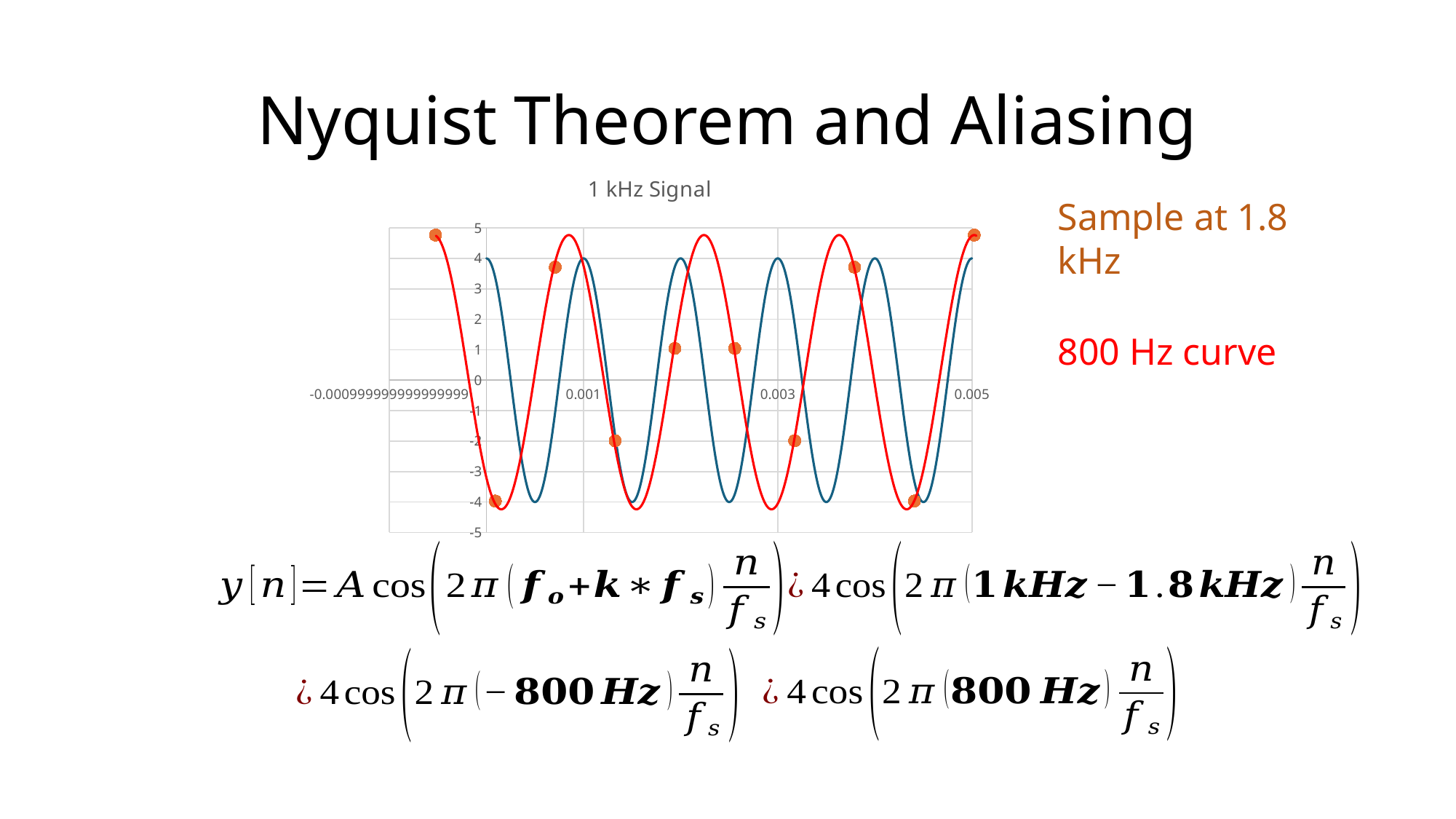
What colour is the 800 Hz curve in the chart? red What kind of chart is shown on the slide? line chart How many orange sample points are marked on the chart? 10 Is the peak value of the red curve greater or less than 4? greater Which curve reaches a higher peak value, the red curve or the blue curve? red curve How many curves are plotted in the chart? 2 Is the peak value of the blue curve greater or less than 5? less What is the lowest tick value shown on the vertical axis? -5 Is the minimum value of the red curve greater or less than -4? less What is the title of the chart? 1 kHz Signal What is the highest tick value shown on the vertical axis? 5 What is the rightmost tick value shown on the horizontal axis? 0.005